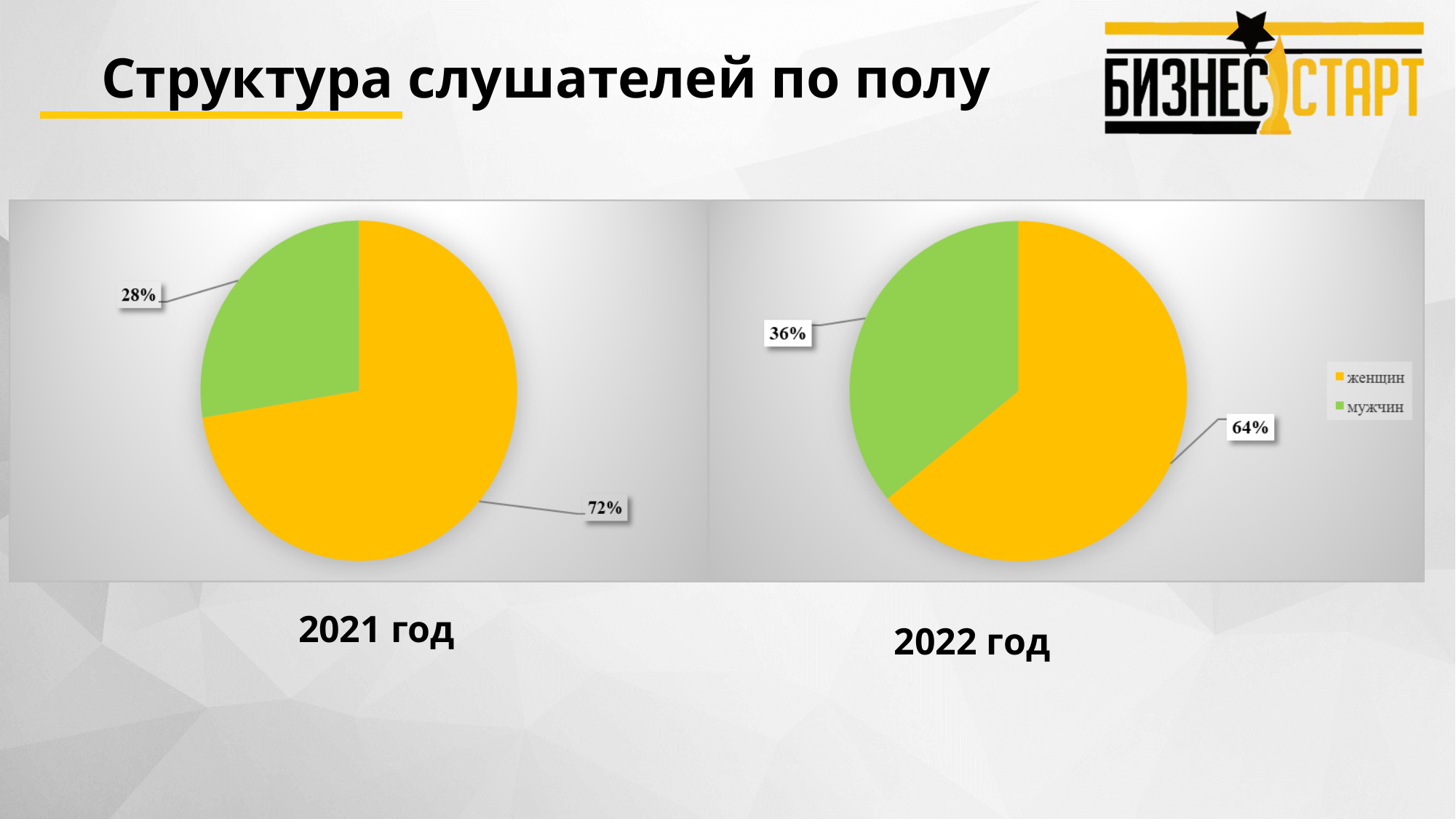
In the 2021 год pie chart, what is the difference between the женщин and мужчин shares? 44% In the 2021 год pie chart, what share of listeners are мужчин? 28% In the 2021 год pie chart, which category has the largest slice? женщин In the 2022 год pie chart, which category has the smallest slice? мужчин In the 2022 год pie chart, what share of listeners are мужчин? 36% In the 2022 год pie chart, what share of listeners are женщин? 64% Is the share of мужчин larger in the 2021 год chart or the 2022 год chart? 2022 год How many categories does the legend of the 2022 год chart list? 2 In the 2021 год pie chart, what share of listeners are женщин? 72% In the 2022 год pie chart, what colour represents мужчин? Green In the 2022 год pie chart, what is the difference between the женщин and мужчин shares? 28% What type of chart is used on this slide? Pie chart